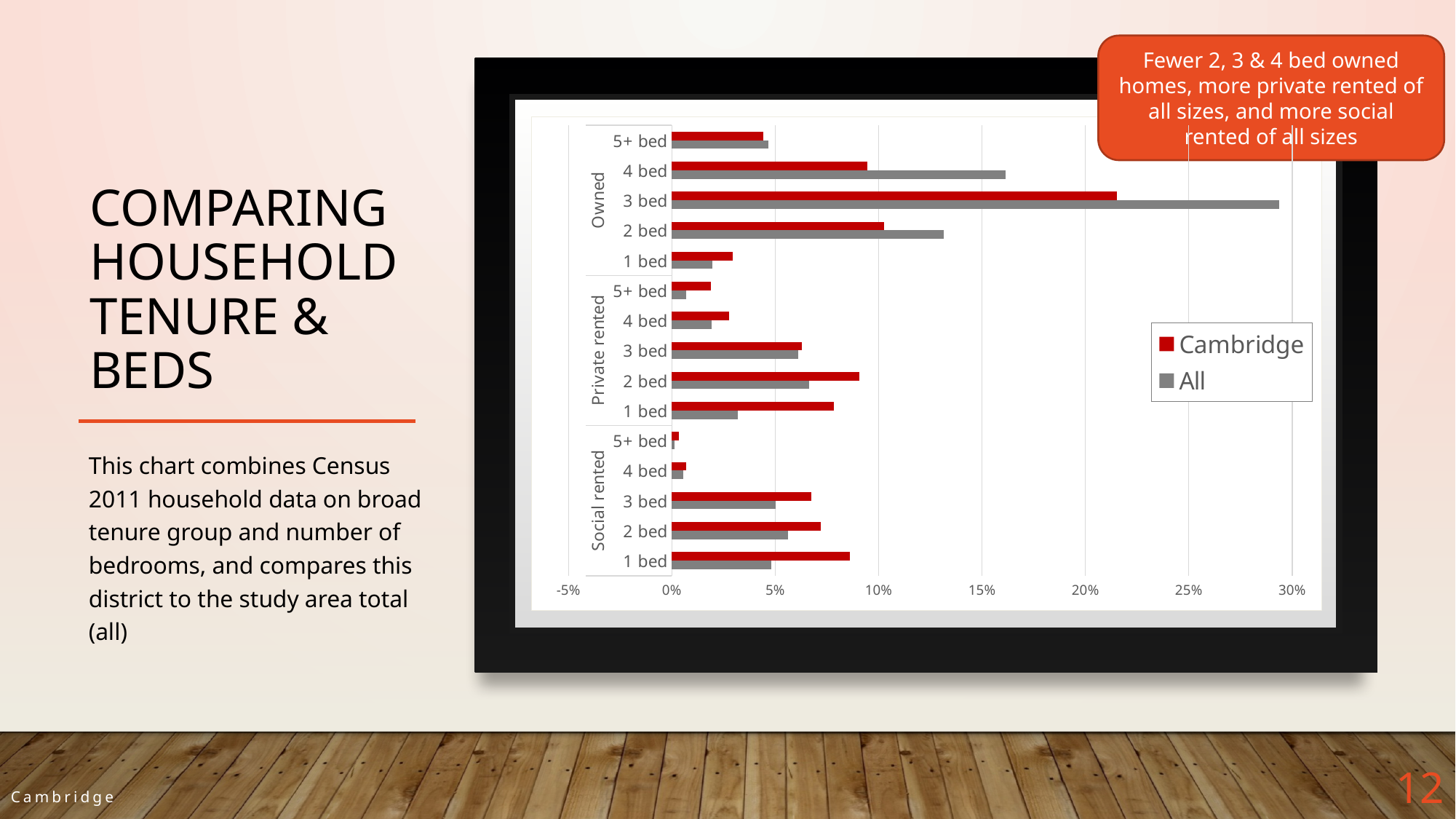
What kind of chart is shown on the slide? Bar chart Which colour represents the Cambridge series in the chart? Red Which category has the highest value for the Cambridge series? Owned 3 bed Which two series are listed in the chart legend? Cambridge and All Is the Cambridge value for Owned 4 bed greater or less than 10%? less How many bedroom categories are plotted in the chart in total across the three tenure groups? 15 For Owned 2 bed, which series has the larger value, Cambridge or All? All How many series does the chart legend list? 2 For Private rented 1 bed, which series has the larger value, Cambridge or All? Cambridge Which category has the highest value for the All series? Owned 3 bed Is the All value for Owned 4 bed greater or less than 15%? greater Is the All value for Owned 3 bed greater or less than 25%? greater